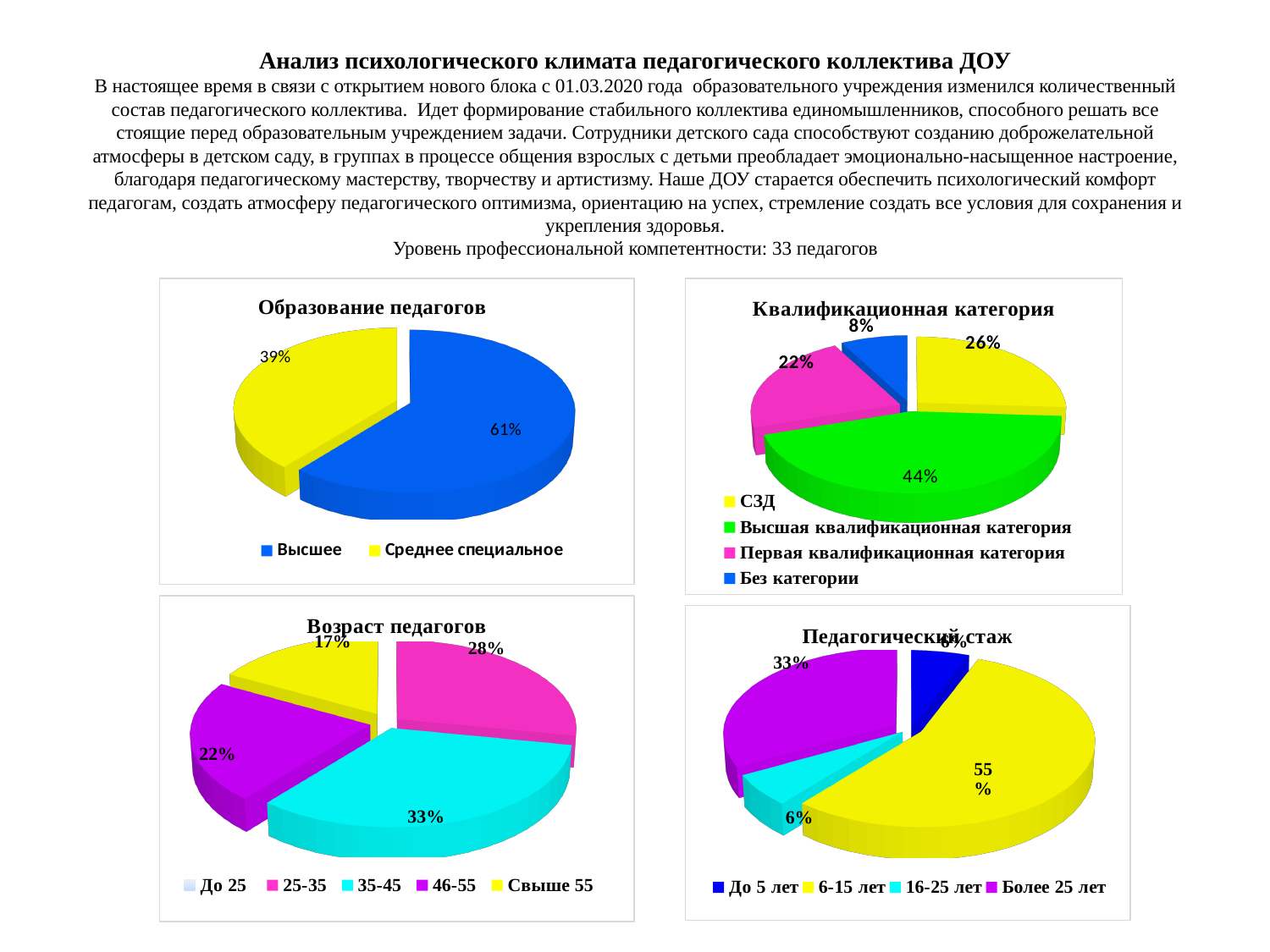
In the 'Образование педагогов' chart, what is the share for 'Среднее специальное'? 39% In the 'Квалификационная категория' chart, what is the share for 'Без категории'? 8% In the 'Квалификационная категория' chart, what is the difference between the 'СЗД' share and the 'Первая квалификационная категория' share? 4% How many entries does the legend of the 'Квалификационная категория' chart list? 4 In the 'Возраст педагогов' chart, what is the share for 'Свыше 55'? 17% In the 'Педагогический стаж' chart, what is the share for 'Более 25 лет'? 33% What type of chart is 'Педагогический стаж'? Pie chart In the 'Возраст педагогов' chart, which is larger: the share for '25-35' or the share for '46-55'? 25-35 In the 'Образование педагогов' chart, what percentage of teachers have 'Высшее' education? 61% In the 'Квалификационная категория' chart, which category has the largest share? Высшая квалификационная категория In the 'Педагогический стаж' chart, which category has the largest share? 6-15 лет In the 'Возраст педагогов' chart, what is the share for the '35-45' age group? 33%